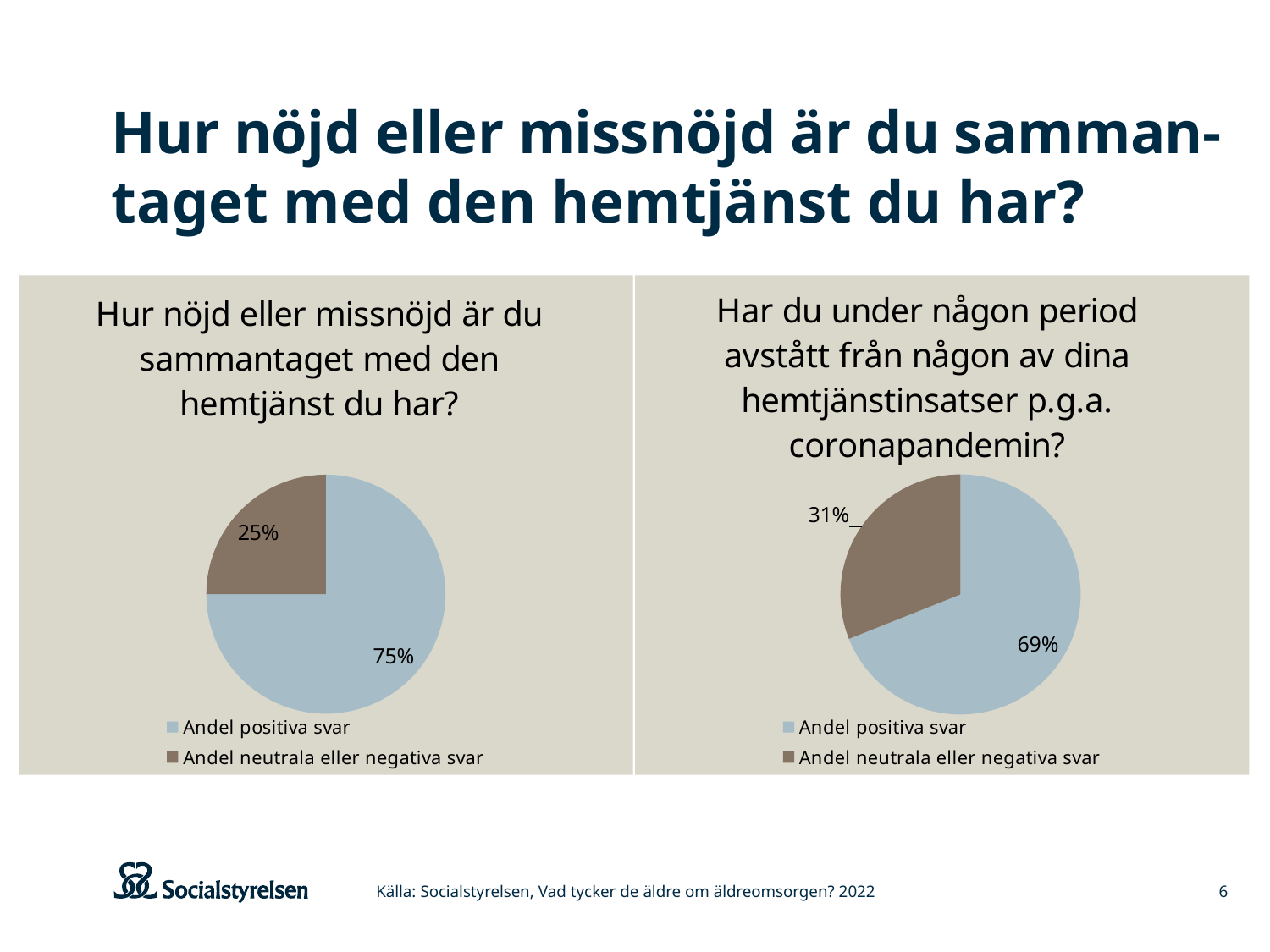
In the right pie chart, which slice is the smallest? Andel neutrala eller negativa svar In the left pie chart, which slice is the largest? Andel positiva svar In the left pie chart ("Hur nöjd eller missnöjd är du sammantaget med den hemtjänst du har?"), what share is labelled for Andel positiva svar? 75% How many entries does the legend of the left pie chart list? 2 Which chart has the larger share for Andel positiva svar, the left pie chart or the right pie chart? The left pie chart In the right pie chart, what share is labelled for Andel neutrala eller negativa svar? 31% How many slices does the right pie chart have? 2 In the left pie chart, what is the difference in percentage points between Andel positiva svar and Andel neutrala eller negativa svar? 50 percentage points In the right pie chart ("Har du under någon period avstått från någon av dina hemtjänstinsatser p.g.a. coronapandemin?"), what share is labelled for Andel positiva svar? 69% In the left pie chart, what share is labelled for Andel neutrala eller negativa svar? 25% What type of chart is used on the left side of the slide? Pie chart In the right pie chart, what is the difference in percentage points between Andel positiva svar and Andel neutrala eller negativa svar? 38 percentage points